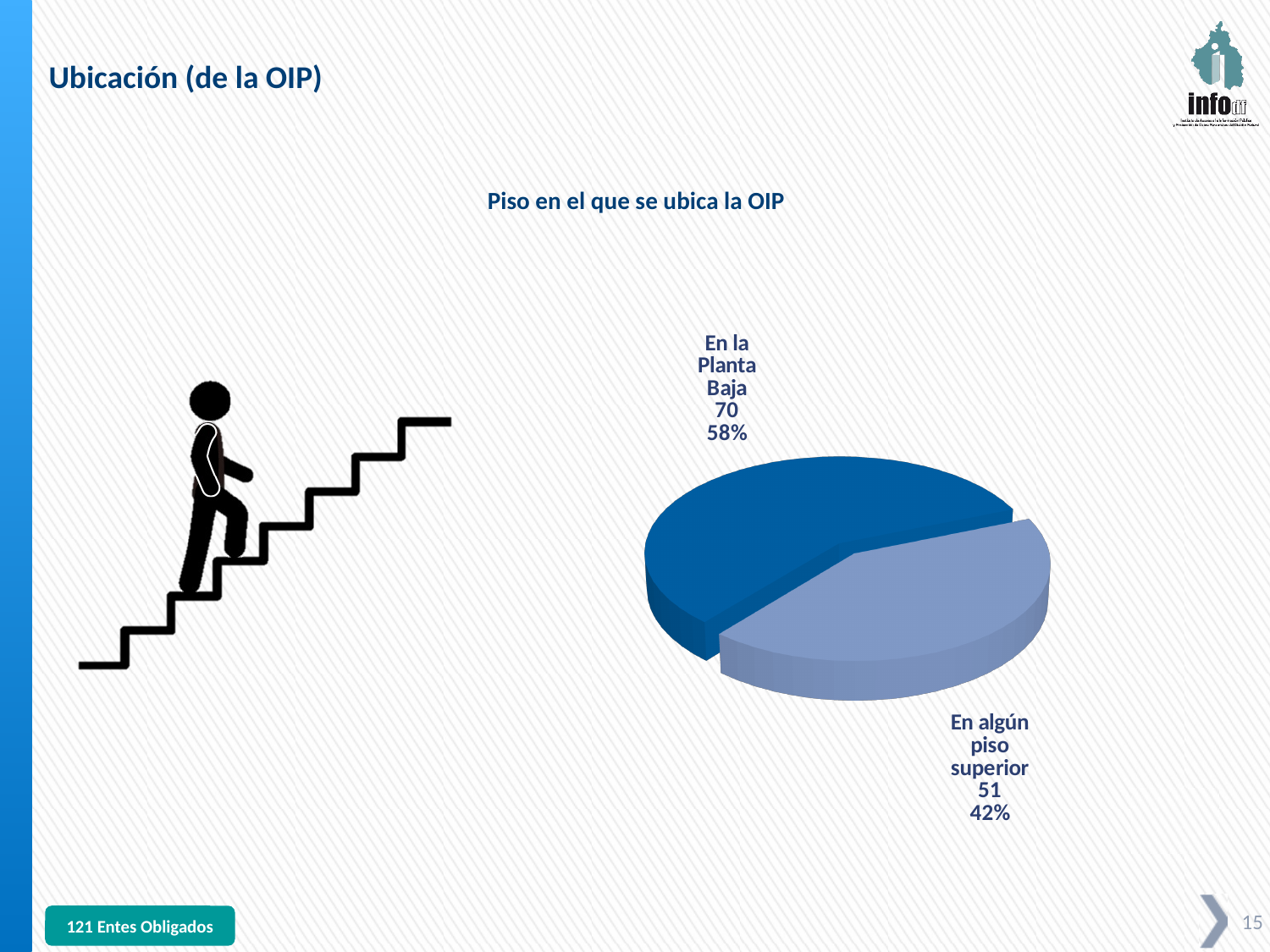
What is the count for 'En algún piso superior'? 51 What is the difference between the counts for 'En la Planta Baja' and 'En algún piso superior'? 19 What is the count for 'En la Planta Baja'? 70 Which is larger, the count for 'En la Planta Baja' or for 'En algún piso superior'? En la Planta Baja What percentage share does 'En la Planta Baja' have? 58% How many slices does the pie chart have? 2 Which category has the largest slice? En la Planta Baja What type of chart is shown on the slide? pie chart What is the total of the two slice counts? 121 What percentage share does 'En algún piso superior' have? 42% Which category has the smallest slice? En algún piso superior What is the title of the chart? Piso en el que se ubica la OIP